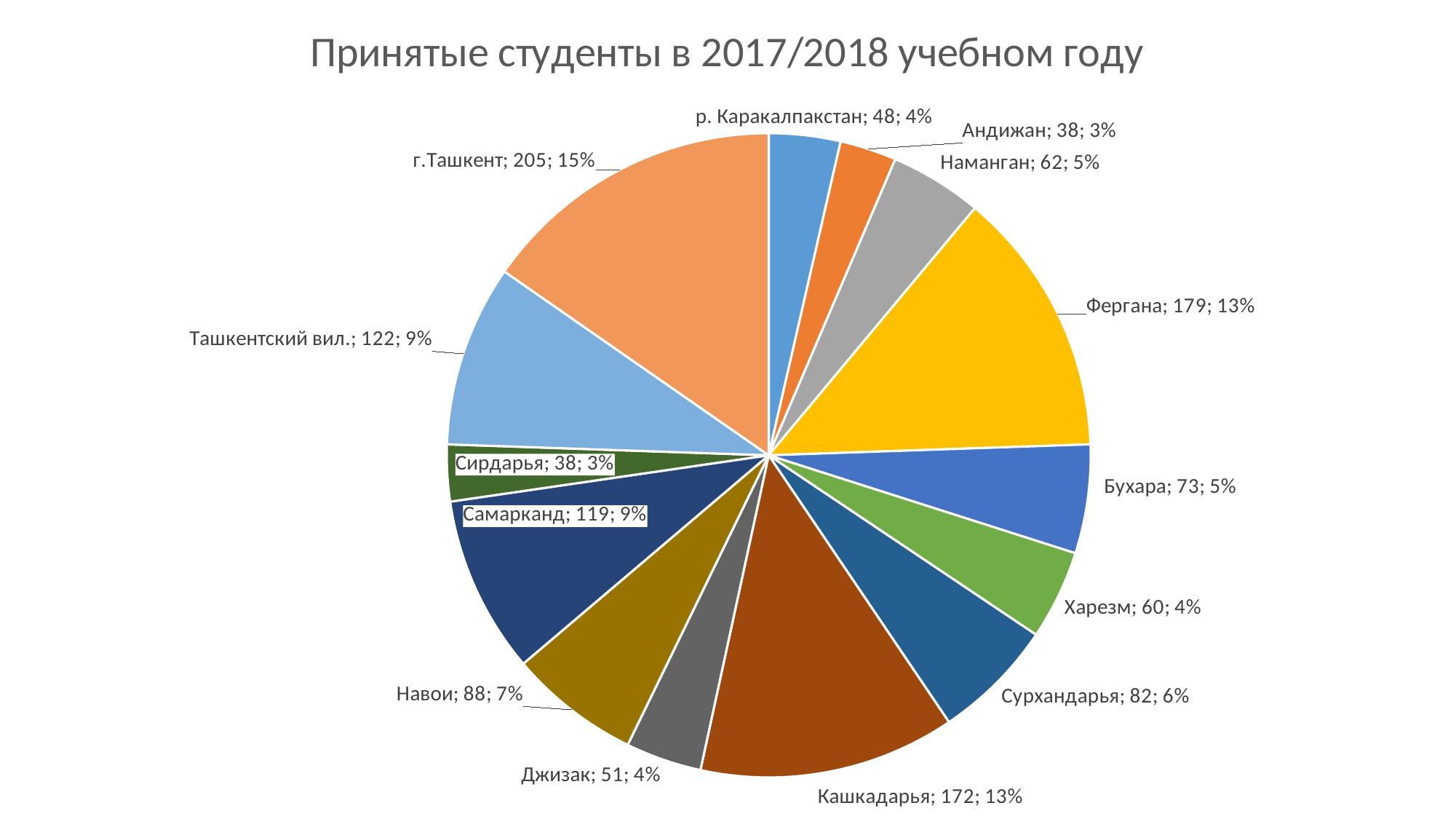
What is the value shown for Навои? 88 What is the value shown for Самарканд? 119 What kind of chart is shown on the slide? pie chart Which region has the largest slice of the pie? г.Ташкент What share of the pie does Кашкадарья represent? 13% Which is larger, the value for Бухара or the value for Наманган? Бухара What is the title of the chart? Принятые студенты в 2017/2018 учебном году What is the difference between the values for г.Ташкент and Ташкентский вил.? 83 How many students were admitted from Фергана? 179 What is the difference between the values for Фергана and Кашкадарья? 7 What share of the pie does г.Ташкент represent? 15% How many slices does the pie chart have? 14